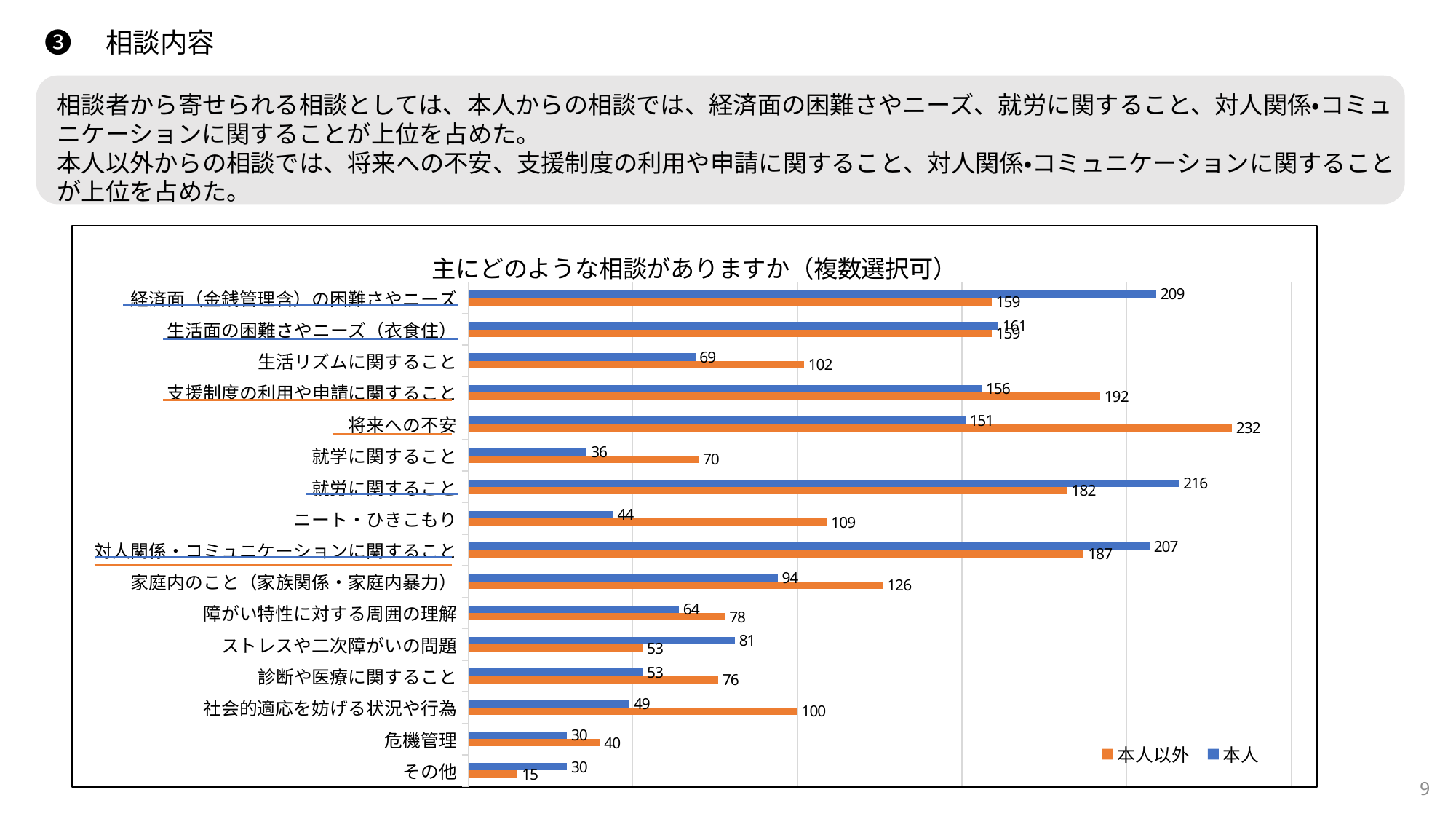
Which category has the highest 本人 value? 就労に関すること What is the difference between the 本人以外 and 本人 values for 支援制度の利用や申請に関すること? 36 Which category has the highest 本人以外 value? 将来への不安 What is the 本人以外 value for ニート・ひきこもり? 109 What is the 本人以外 value for 将来への不安? 232 How many categories are plotted in the chart? 16 Which colour represents the 本人以外 series in the chart? orange What kind of chart is shown on the slide? bar chart For 対人関係・コミュニケーションに関すること, which is larger, the 本人 value or the 本人以外 value? 本人 Which category has the lowest 本人以外 value? その他 What is the 本人 value for 経済面（金銭管理含）の困難さやニーズ? 209 How many series does the legend list? 2